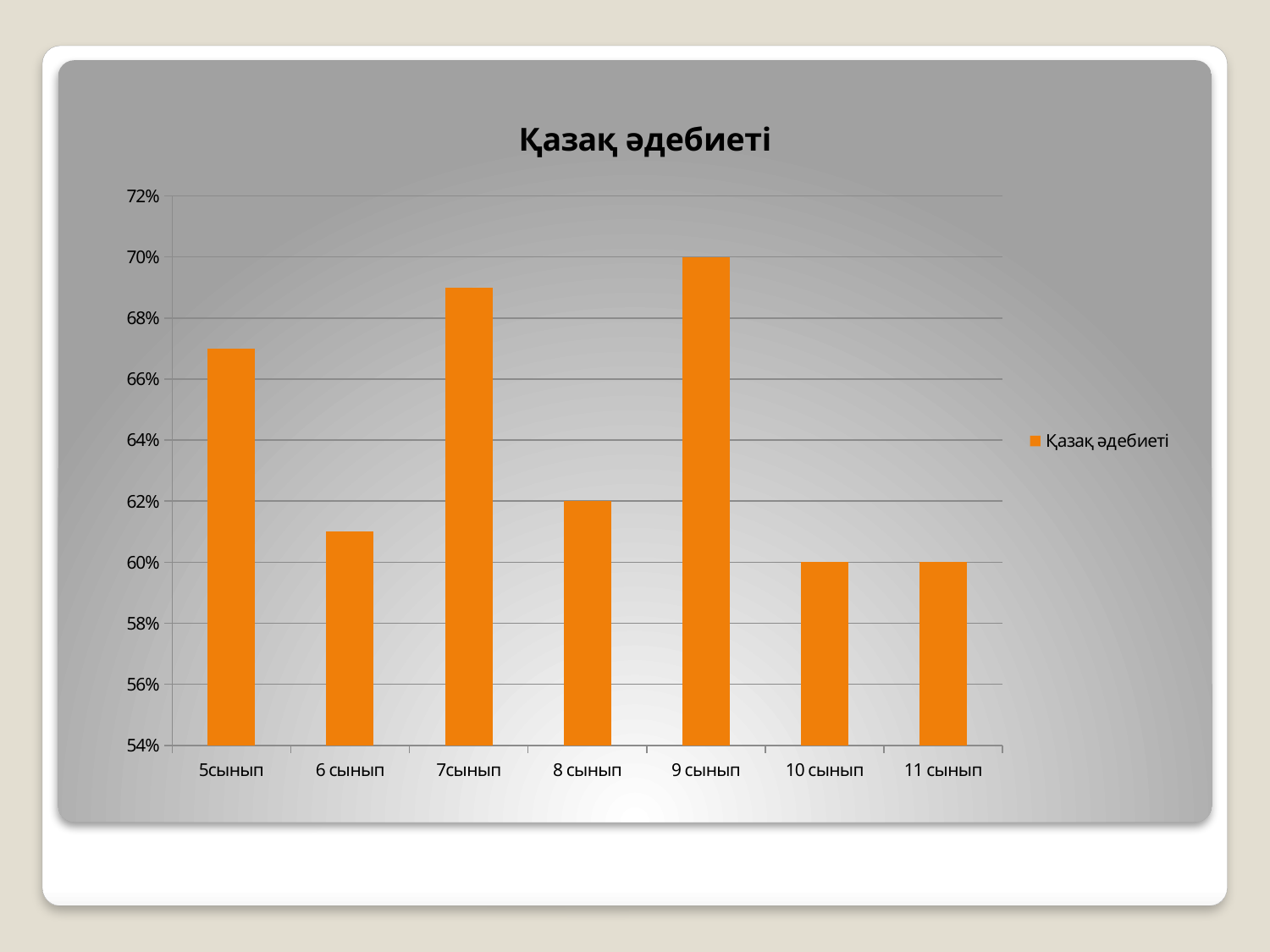
Is the value for 6 сынып greater or less than 62%? less What is the value for 8 сынып? 62% What is the difference between the values for 9 сынып and 8 сынып? 8% What is the value for 9 сынып? 70% Which is larger, the value for 7сынып or the value for 8 сынып? 7сынып Is the value for 5сынып greater or less than 66%? greater How many series does the legend list? 1 What is the title of the chart? Қазақ әдебиеті What is the value for 10 сынып? 60% How many categories are shown on the x axis? 7 What kind of chart is shown on the slide? bar chart Which category has the highest value? 9 сынып